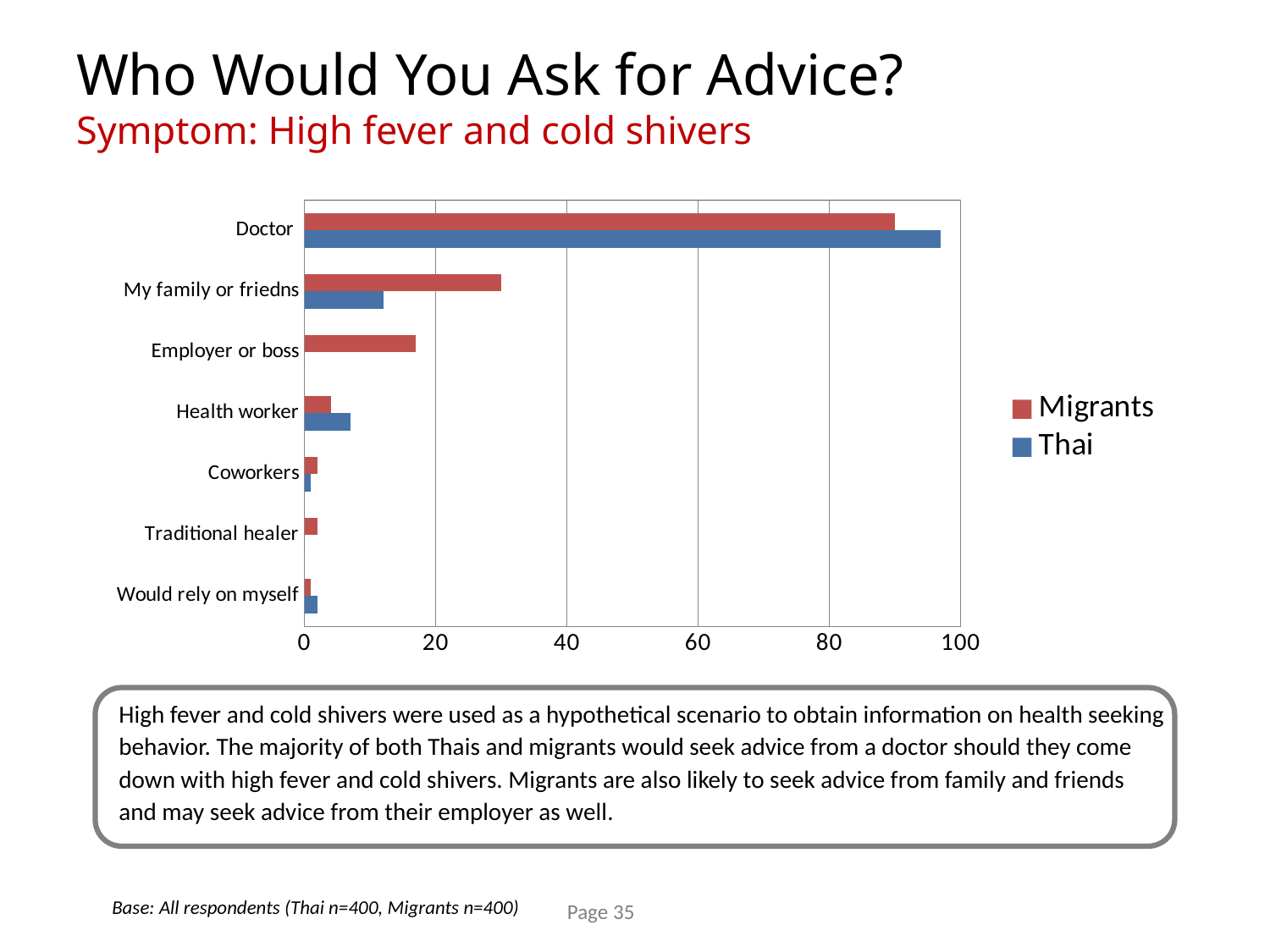
Is the Thai value for My family or friedns greater or less than 20? less For Doctor, which series has the larger value, Migrants or Thai? Thai What colour represents the Thai series in the legend? Blue What kind of chart is shown on the slide? Bar chart How many series does the legend list? 2 How many categories are shown on the chart? 7 For My family or friedns, which series has the larger value, Migrants or Thai? Migrants Which category has the highest value for Thai? Doctor Which category has the highest value for Migrants? Doctor For Health worker, which series has the larger value, Migrants or Thai? Thai Is the Migrants value for My family or friedns greater or less than 20? greater Is the Migrants value for Doctor greater or less than 80? greater